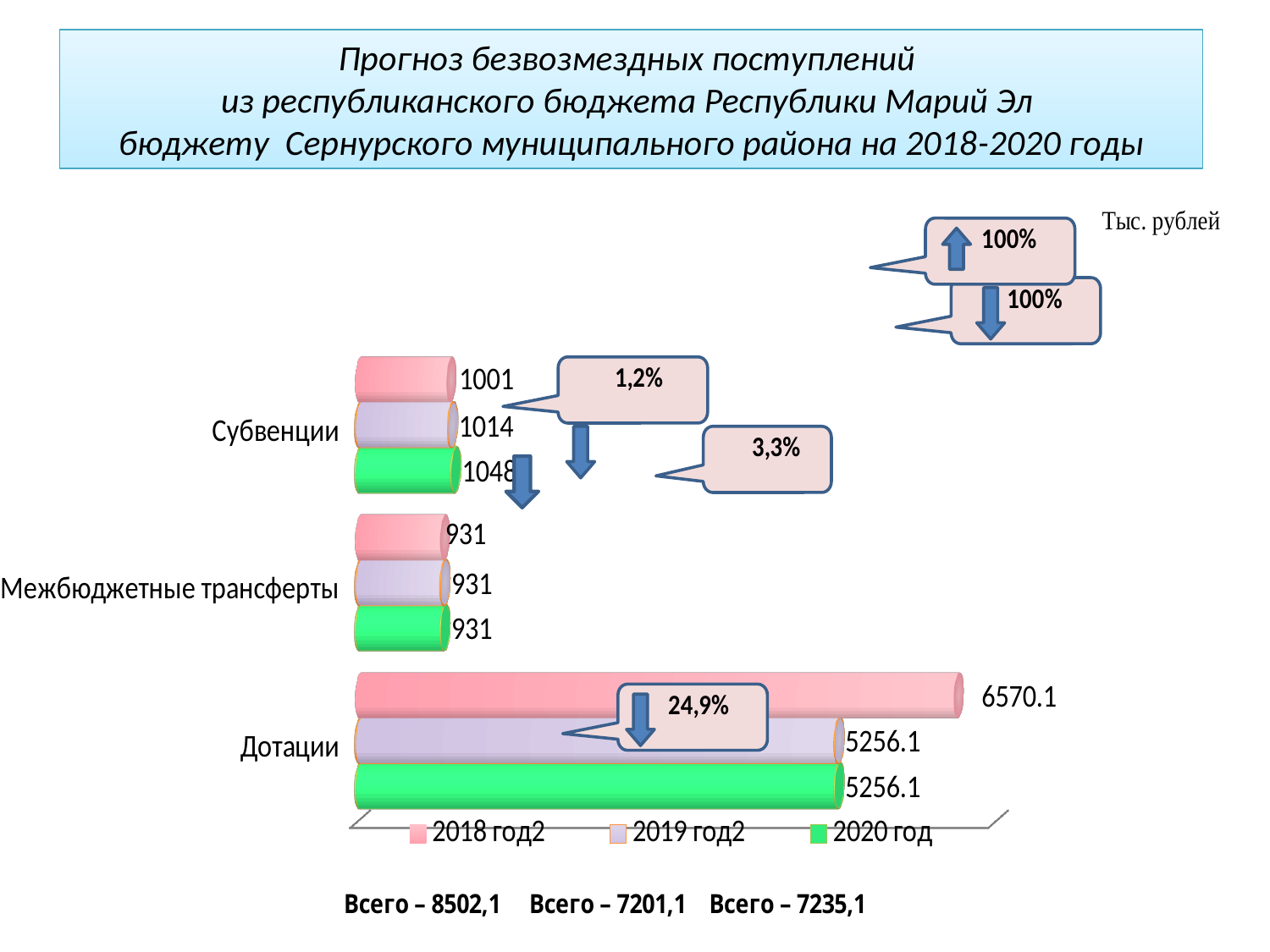
Which category has the lowest value in the 2020 год series? Межбюджетные трансферты What is the value for Дотации in the 2018 год2 series? 6570.1 How many categories are shown on the chart? 3 Which category has the highest value in the 2018 год2 series? Дотации How many series does the legend list? 3 What kind of chart is shown on the slide? Bar chart What is the value for Межбюджетные трансферты in the 2019 год2 series? 931 What is the value for Дотации in the 2020 год series? 5256.1 What is the difference between the 2018 год2 and 2019 год2 values for Дотации? 1314 What is the difference between the 2020 год and 2018 год2 values for Субвенции? 47 Which is larger for Субвенции: the 2018 год2 value or the 2020 год value? 2020 год What is the value for Субвенции in the 2020 год series? 1048